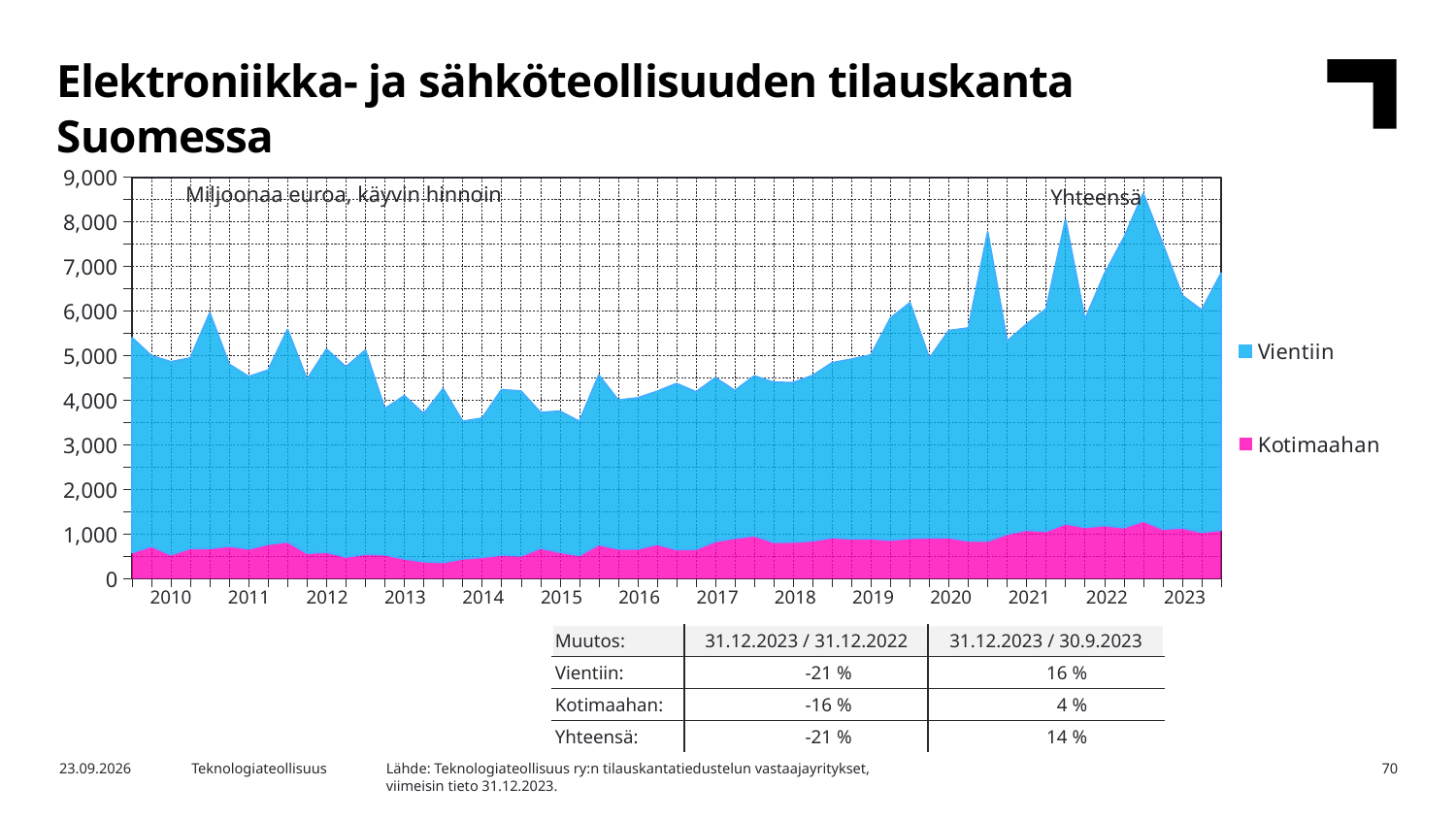
What kind of chart is shown on the slide? Stacked area chart In which year does the total (Yhteensä) reach its highest point on the chart? 2022 Does the total (Yhteensä) value generally rise or fall from 2019 to 2022? rise How many series does the chart legend list? 2 Is the Kotimaahan value in 2022 greater or less than 2,000? less Which series is larger throughout the chart, Vientiin or Kotimaahan? Vientiin What are the two series named in the chart legend? Vientiin and Kotimaahan Is the total (Yhteensä) value at its peak in 2022 greater or less than 8,000? greater Is the Kotimaahan value in 2010 greater or less than 1,000? less What unit is stated in the chart's annotation at the top left of the plot area? Miljoonaa euroa, käyvin hinnoin How many years are labelled on the x axis of the chart? 14